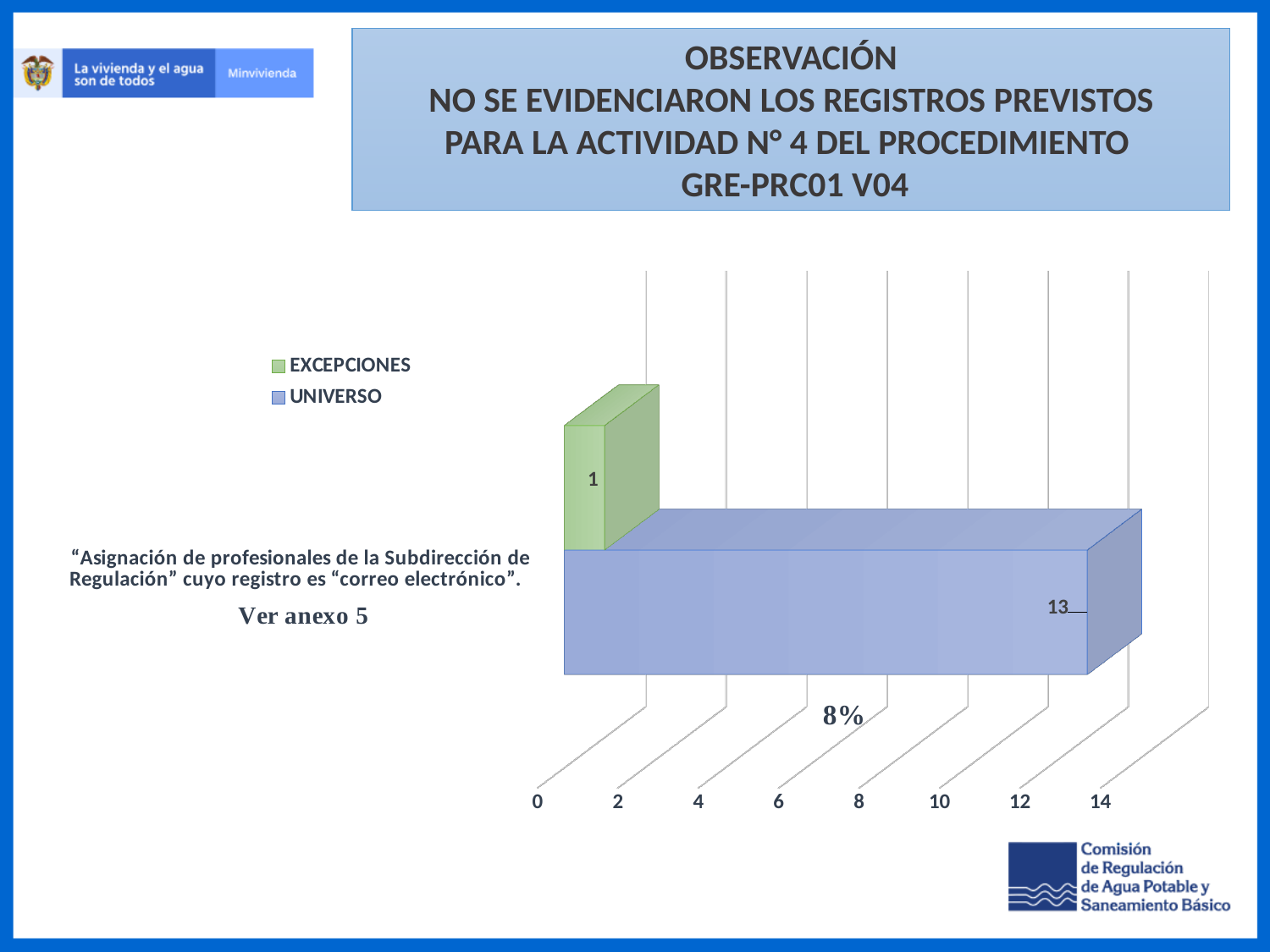
How many series does the legend list? 2 What is the maximum value shown on the horizontal axis? 14 What is the difference between the UNIVERSO value and the EXCEPCIONES value? 12 Which series has the higher value, EXCEPCIONES or UNIVERSO? UNIVERSO What colour is the EXCEPCIONES series in the legend? Green What is the value for EXCEPCIONES? 1 What is the value for UNIVERSO? 13 What kind of chart is shown on the slide? Bar chart Is the value for UNIVERSO greater or less than 12? greater What percentage is printed below the bars on the chart? 8% Is the value for EXCEPCIONES greater or less than 2? less Which series has the lowest value? EXCEPCIONES